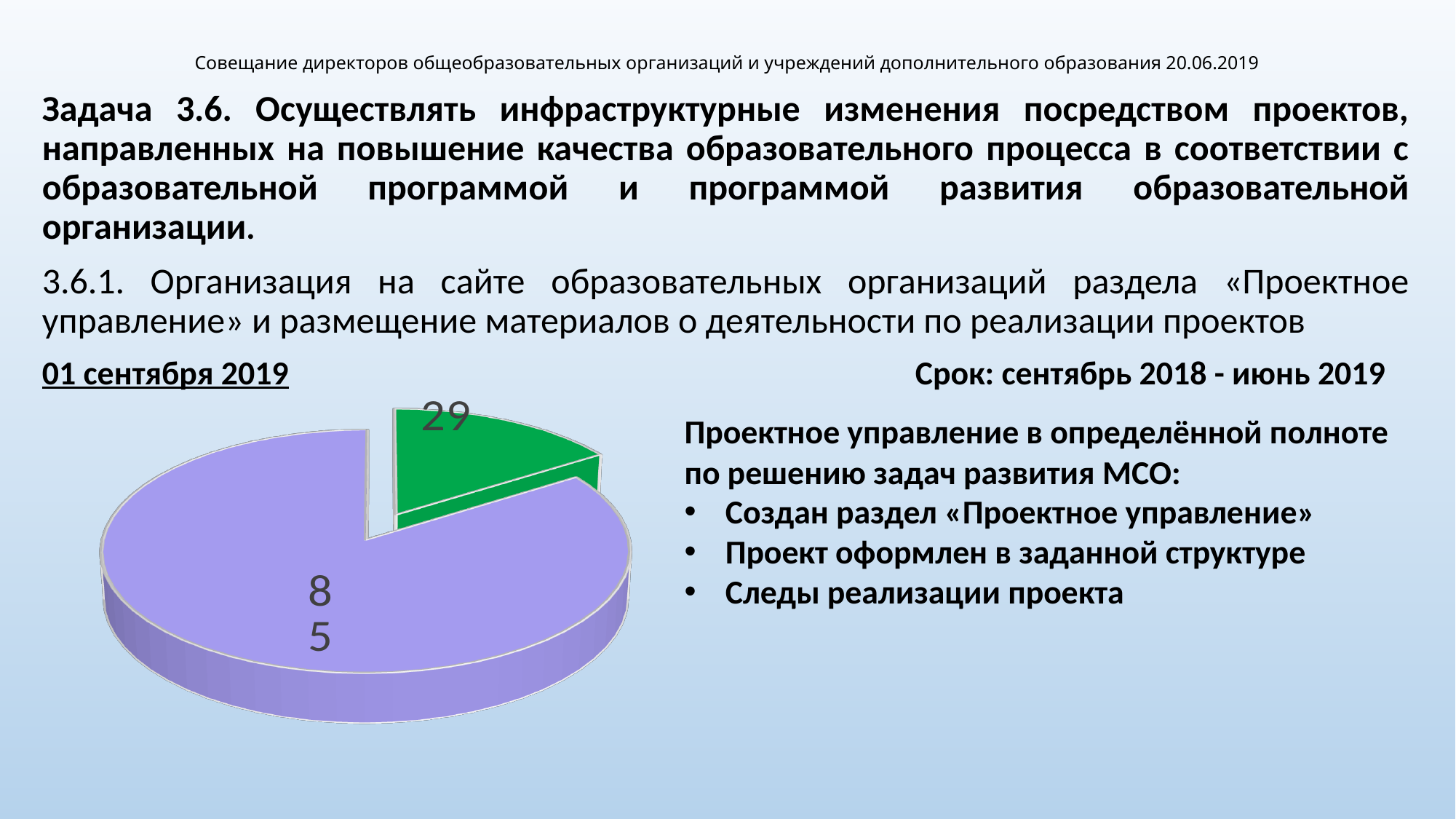
Which slice of the pie chart is pulled out (exploded) from the rest of the pie? the green slice How many slices does the pie chart have? 2 What is the difference between the purple slice value and the green slice value in the pie chart? 56 Which slice of the pie chart is the smallest? the green slice (29) Which is larger in the pie chart, the green slice or the purple slice? the purple slice Does the pie chart have a legend? No What kind of chart is shown on the slide? pie chart What value is shown on the purple slice of the pie chart? 85 What is the total of the two slice values in the pie chart? 114 What value is shown on the green slice of the pie chart? 29 Which slice of the pie chart is the largest? the purple slice (85)